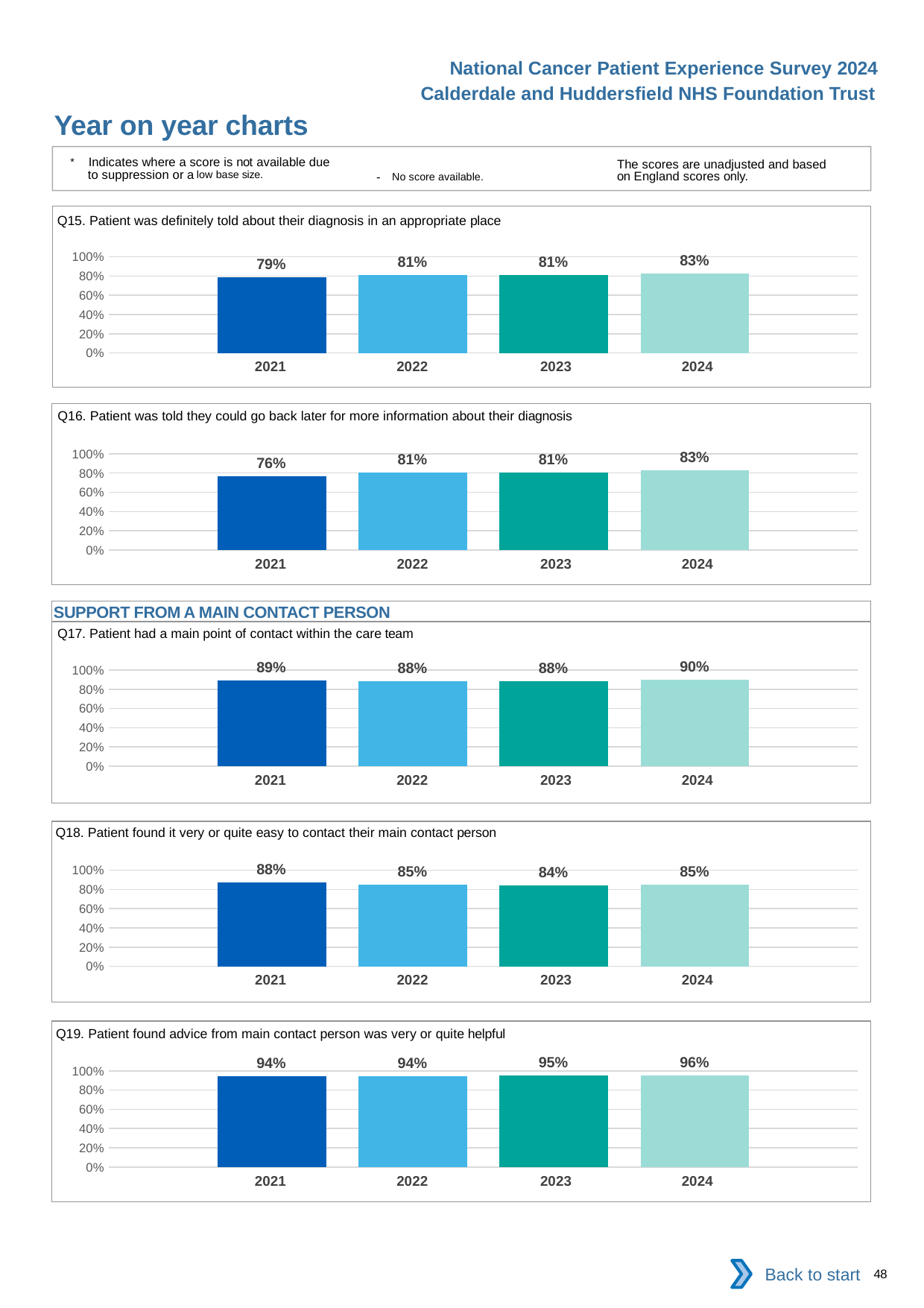
In the Q15 chart, do the values generally rise or fall from 2021 to 2024? rise In the Q18 chart (Patient found it very or quite easy to contact their main contact person), which year has the highest value? 2021 What type of chart is used for Q18? bar chart In the Q17 chart, which year has the highest value? 2024 In the Q16 chart (Patient was told they could go back later for more information about their diagnosis), which year has the lowest value? 2021 In the Q15 chart (Patient was definitely told about their diagnosis in an appropriate place), what is the value for 2021? 79% In the Q18 chart, what is the value for 2023? 84% In the Q16 chart, what is the difference between the 2024 and 2021 values? 7 percentage points In the Q19 chart (Patient found advice from main contact person was very or quite helpful), what is the value for 2024? 96% In the Q17 chart (Patient had a main point of contact within the care team), what is the value for 2024? 90% How many years are shown in the Q15 chart? 4 In the Q19 chart, is the value for 2021 larger or smaller than the value for 2023? smaller